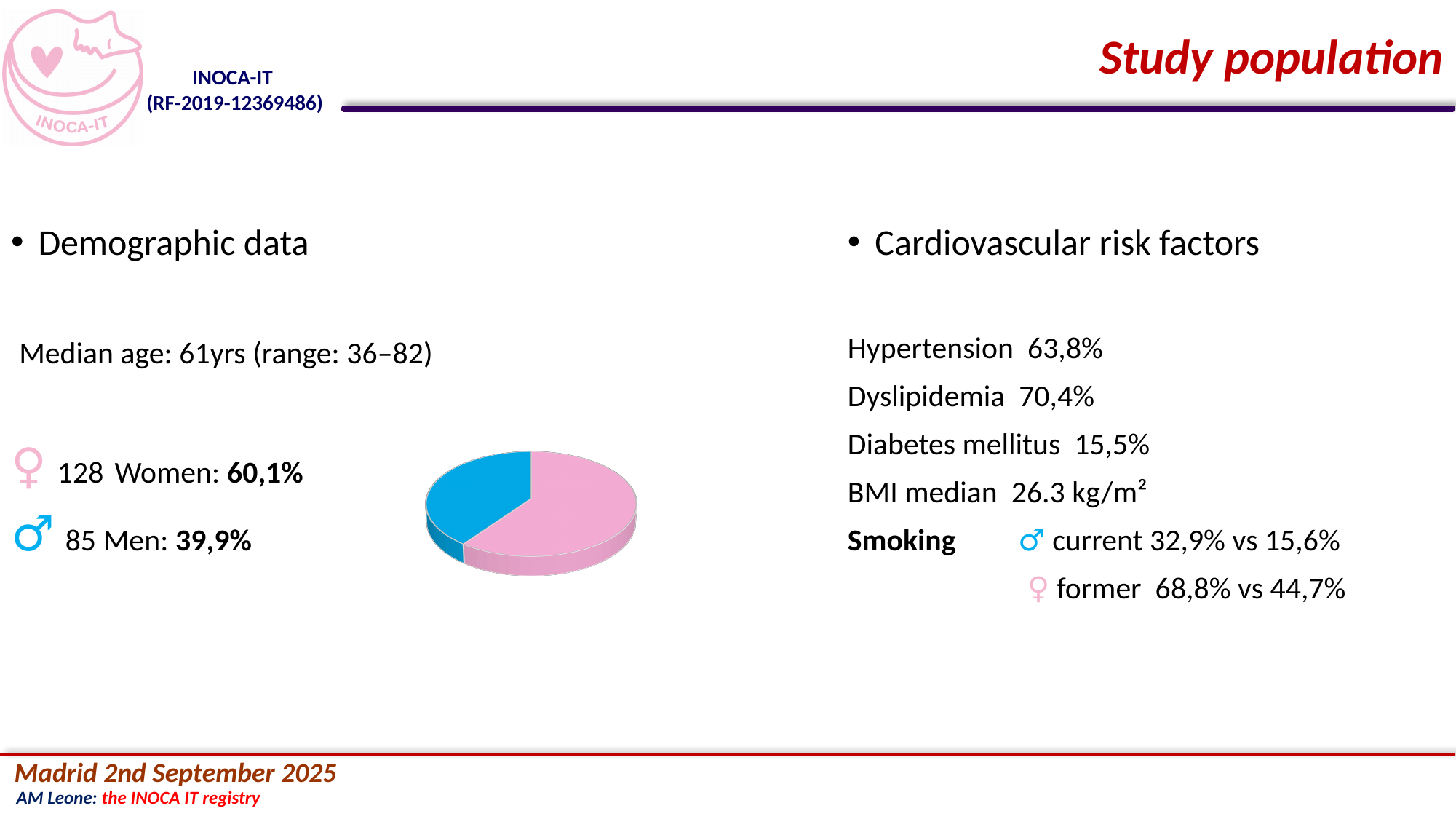
How many men are in the study population shown by the pie chart? 85 How many women are in the study population shown by the pie chart? 128 What colour is the slice representing women in the pie chart? pink Which group does the smaller slice of the pie chart represent, women or men? Men What kind of chart is shown on the slide? pie chart How many slices does the pie chart have? 2 What colour is the slice representing men in the pie chart? blue What share of the pie chart do men account for? 39,9% Which group does the larger slice of the pie chart represent, women or men? Women What is the difference in percentage points between the women's and men's shares of the pie chart? 20,2% What share of the pie chart do women account for? 60,1% Is the share of the pie chart for women greater or less than 50%? greater